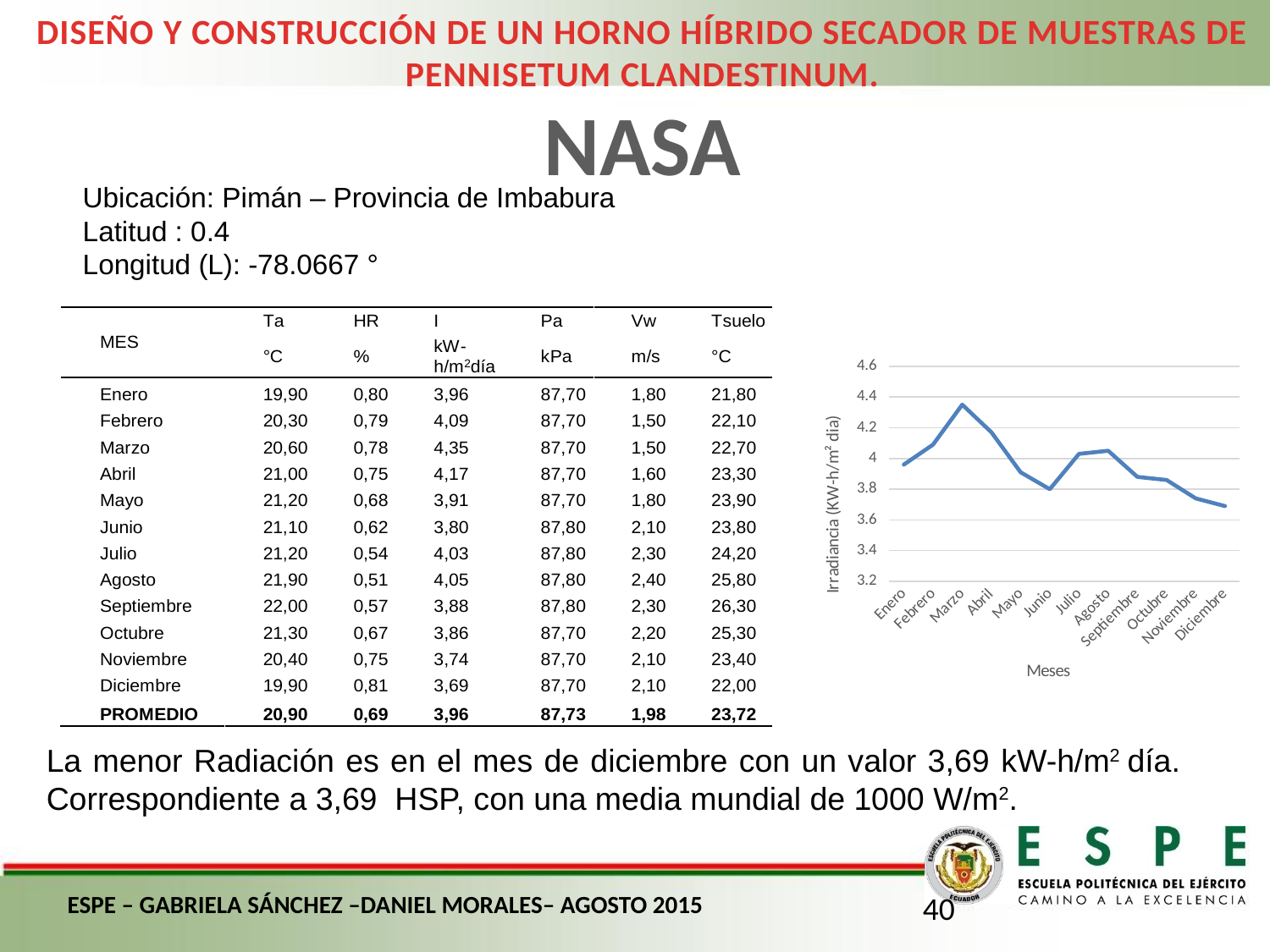
What kind of chart is shown on the slide? line chart Which month has the highest irradiance in the chart? Marzo Does the irradiance rise or fall from Marzo to Junio? fall Which month has the lowest irradiance in the chart? Diciembre Is the irradiance value for Diciembre greater or less than 3.8? less How many months are plotted along the x axis of the irradiance chart? 12 Is the irradiance value for Marzo greater or less than 4.2? greater Using the values printed in the table, what is the difference between the irradiance of Marzo (4,35) and Diciembre (3,69)? 0,66 What is the label on the x axis of the chart? Meses Which has the higher irradiance, Febrero or Noviembre? Febrero What is the irradiance value for Diciembre, as printed in the table (column I)? 3,69 What is the irradiance value for Marzo, as printed in the table (column I)? 4,35